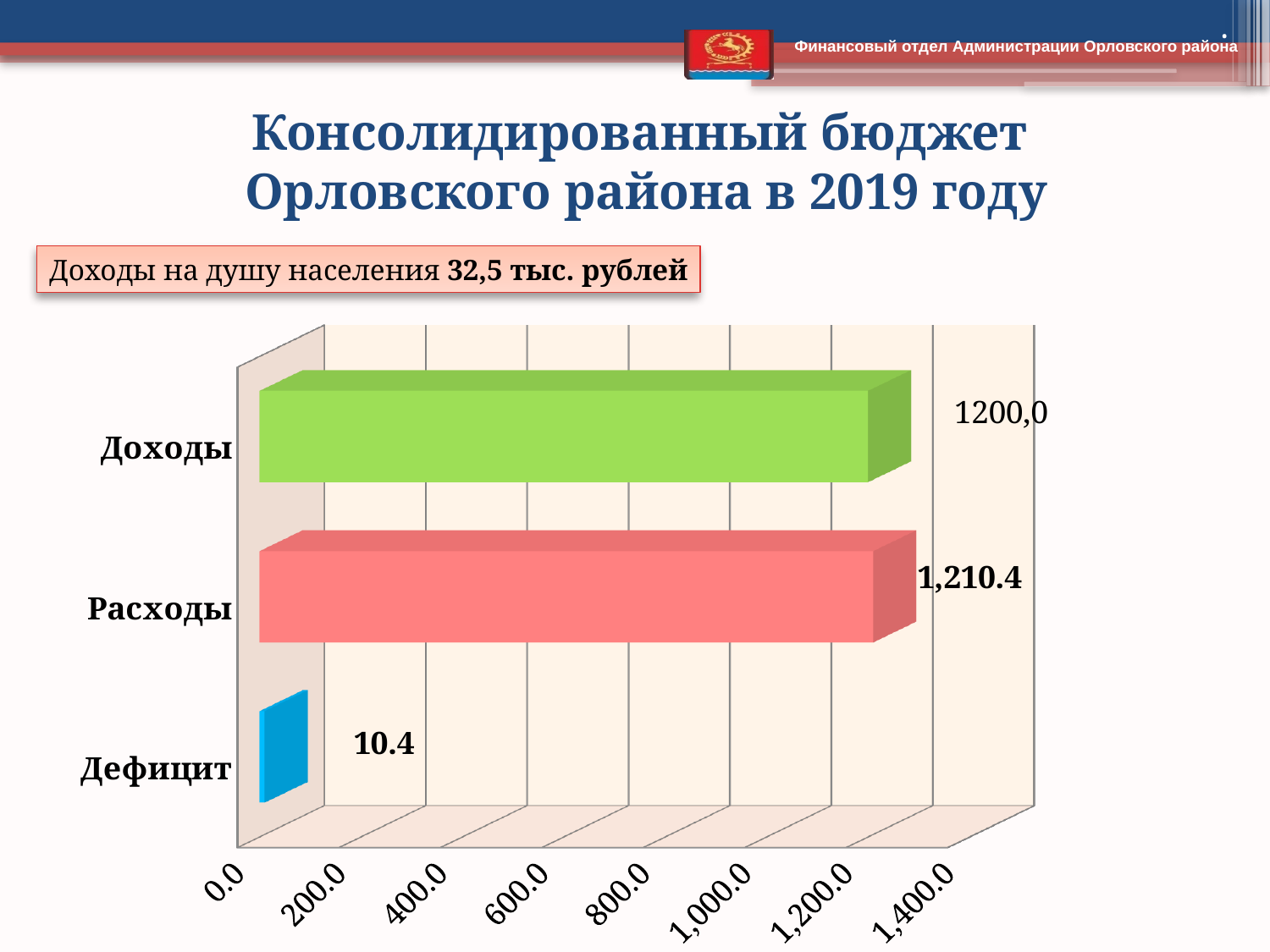
Which is larger, Доходы or Расходы? Расходы What is the value shown for Расходы? 1,210.4 Is the value for Дефицит greater or less than 200.0? less What is the value shown for Доходы? 1200,0 Which category has the highest value? Расходы By how much does Расходы exceed Доходы? 10.4 What is the title of the slide? Консолидированный бюджет Орловского района в 2019 году Is the value for Доходы greater or less than 1,000.0? greater What kind of chart is shown on the slide? Bar chart Which category has the lowest value? Дефицит How many categories are shown in the chart? 3 What is the value shown for Дефицит? 10.4